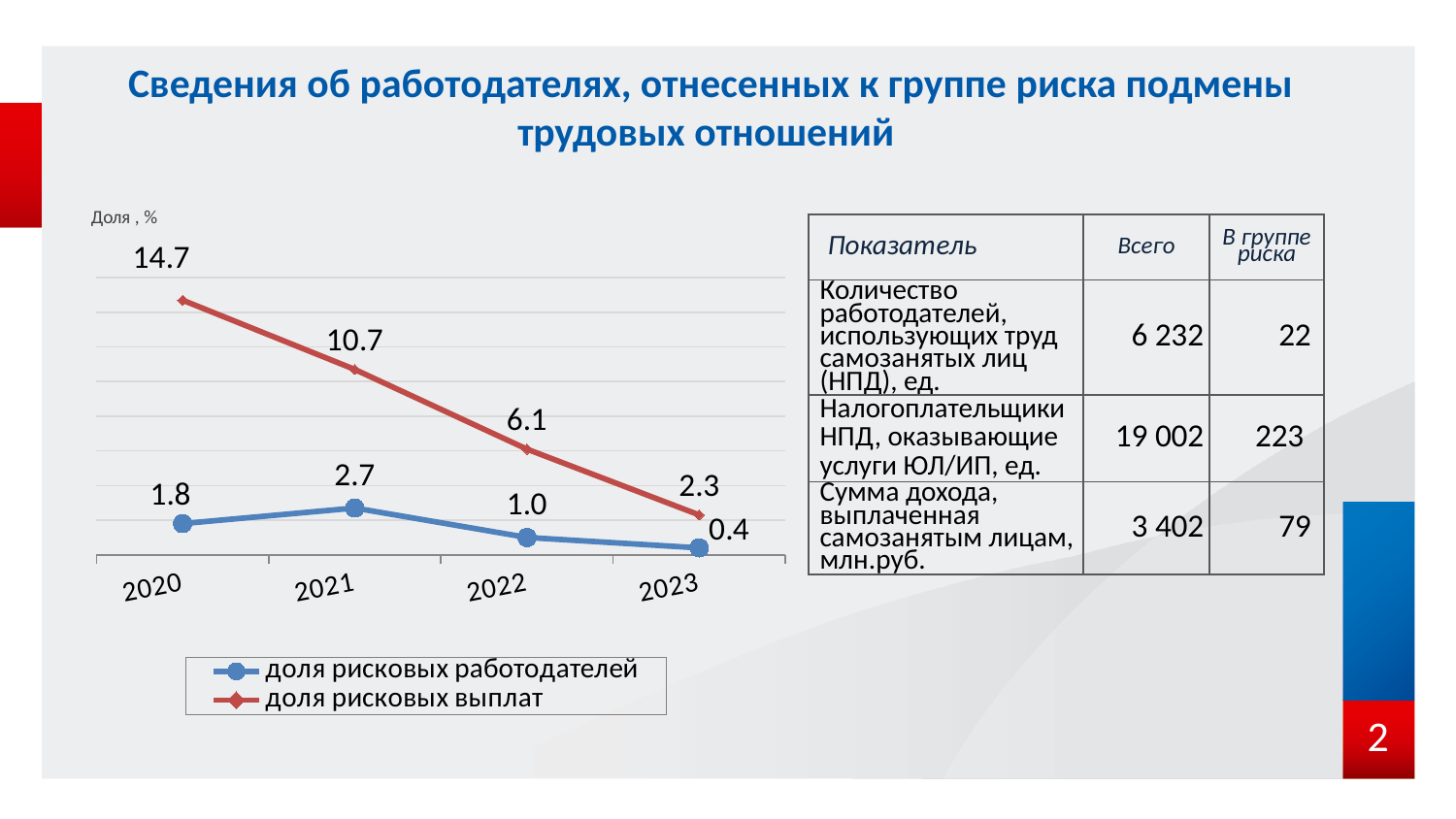
What is the value of "доля рисковых выплат" in 2023? 2.3 What colour is the line for "доля рисковых выплат"? red What is the value of "доля рисковых работодателей" in 2021? 2.7 In which year is "доля рисковых работодателей" highest? 2021 What type of chart is shown on the slide? line chart In which year is "доля рисковых выплат" lowest? 2023 Which series has the larger value in 2022, "доля рисковых работодателей" or "доля рисковых выплат"? доля рисковых выплат What is the value of "доля рисковых выплат" in 2020? 14.7 Does "доля рисковых выплат" rise or fall from 2020 to 2023? fall What is the difference between "доля рисковых выплат" in 2020 and in 2021? 4.0 How many series does the chart legend list? 2 How many years are plotted on the x axis of the chart? 4